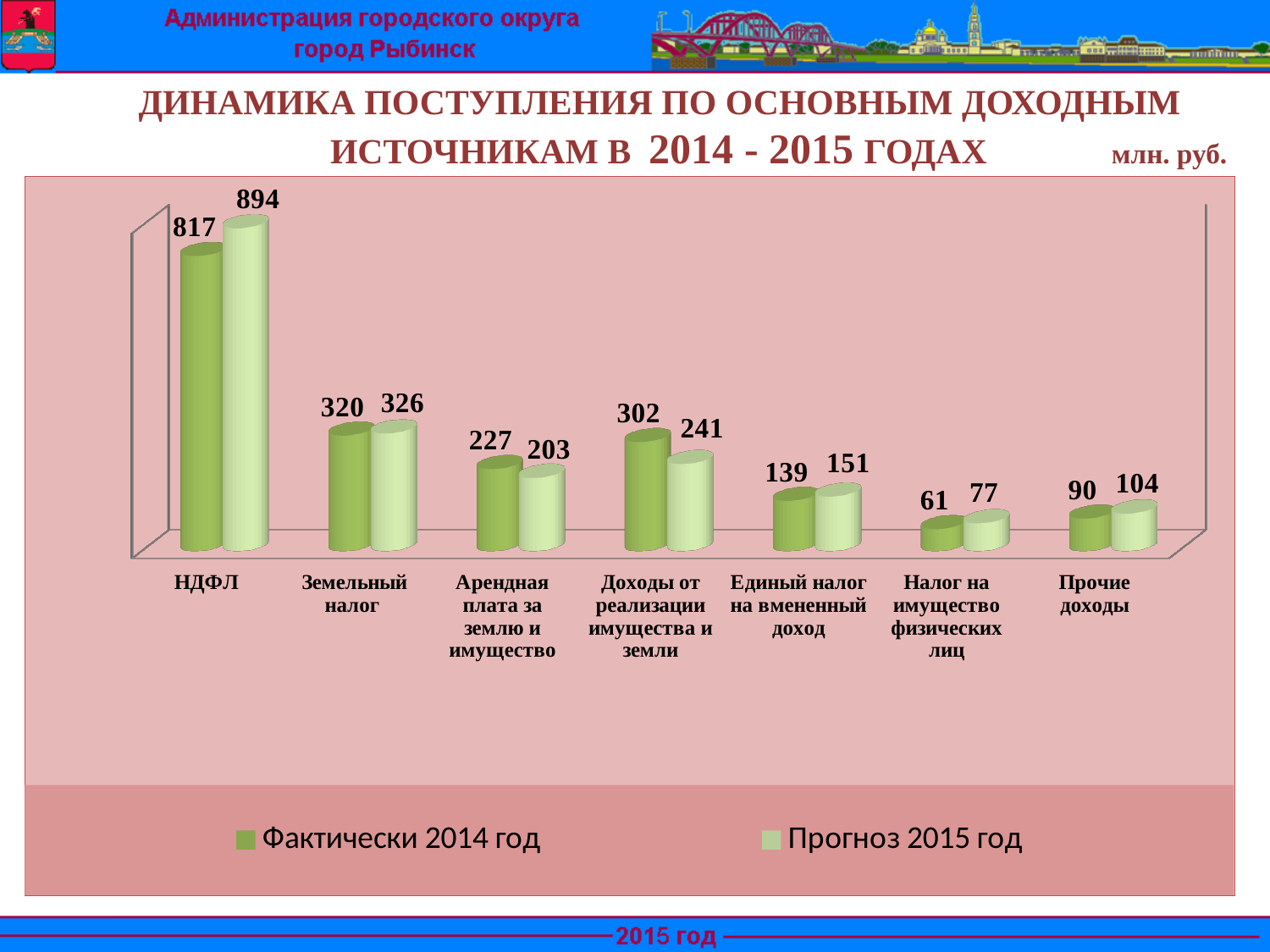
How many series does the legend list? 2 What is the difference between the Фактически 2014 год and Прогноз 2015 год values for Доходы от реализации имущества и земли? 61 What is the difference between the Прогноз 2015 год and Фактически 2014 год values for НДФЛ? 77 How many categories are shown on the x axis? 7 What is the value for Прочие доходы in the Прогноз 2015 год series? 104 Which category has the lowest value in the Фактически 2014 год series? Налог на имущество физических лиц What unit is indicated for the values in the chart? млн. руб. Which category has the highest value in the Прогноз 2015 год series? НДФЛ For Арендная плата за землю и имущество, which series has the larger value: Фактически 2014 год or Прогноз 2015 год? Фактически 2014 год What kind of chart is shown on the slide? bar chart What is the value for НДФЛ in the Фактически 2014 год series? 817 What is the value for Земельный налог in the Прогноз 2015 год series? 326